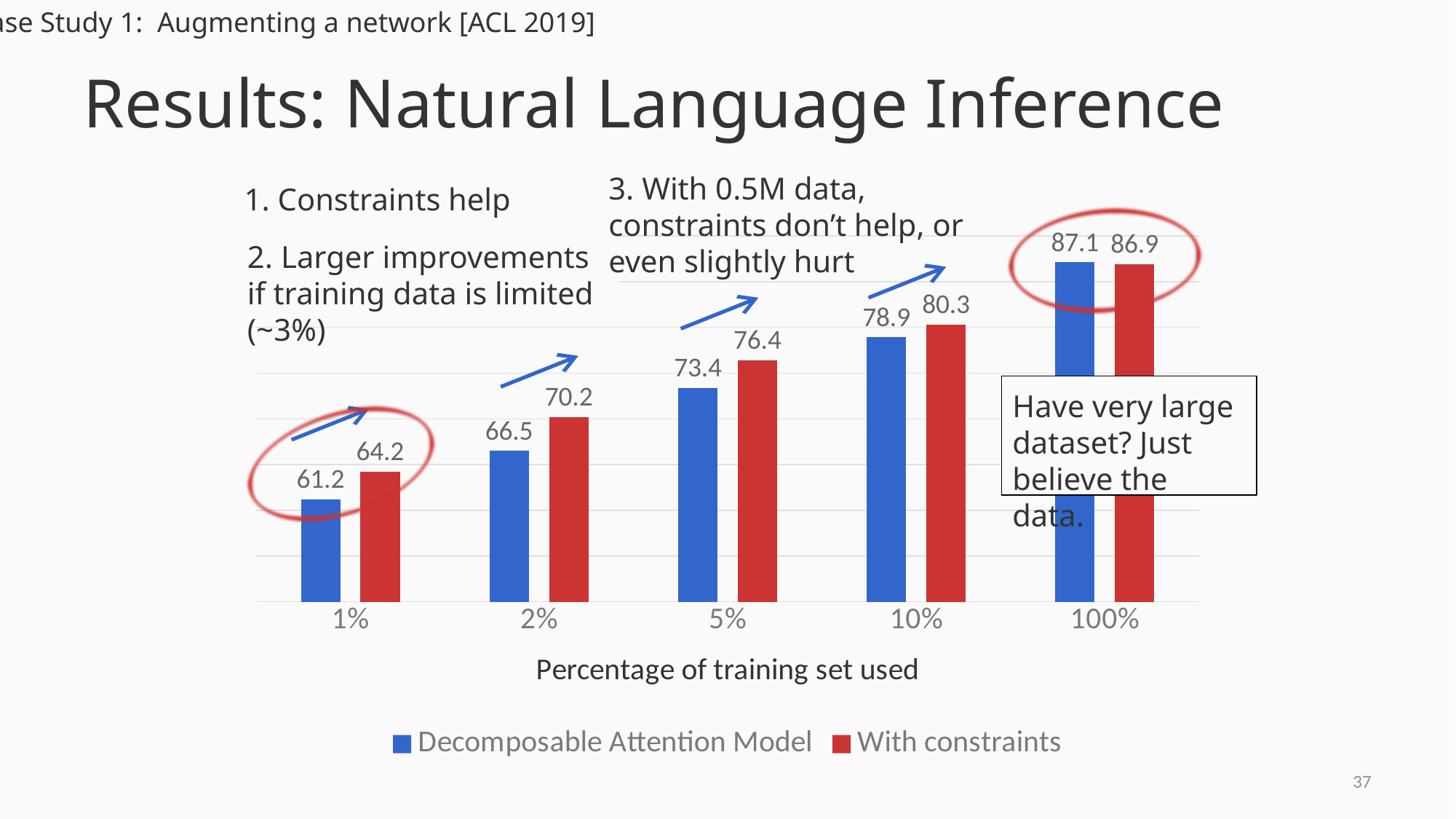
At 100% of the training set, which series has the larger value: Decomposable Attention Model or With constraints? Decomposable Attention Model What is the value for the Decomposable Attention Model at 1% of the training set? 61.2 How many series does the legend list? 2 How many training-set percentage categories are shown on the x axis? 5 What is the value for With constraints at 100% of the training set? 86.9 At which percentage of the training set is the With constraints value lowest? 1% What is the value for With constraints at 5% of the training set? 76.4 At which percentage of the training set is the Decomposable Attention Model value highest? 100% What is the value for the Decomposable Attention Model at 10% of the training set? 78.9 Do the Decomposable Attention Model values rise or fall as the percentage of training set used increases? rise What kind of chart is shown on the slide? bar chart What is the difference between the With constraints value and the Decomposable Attention Model value at 2% of the training set? 3.7